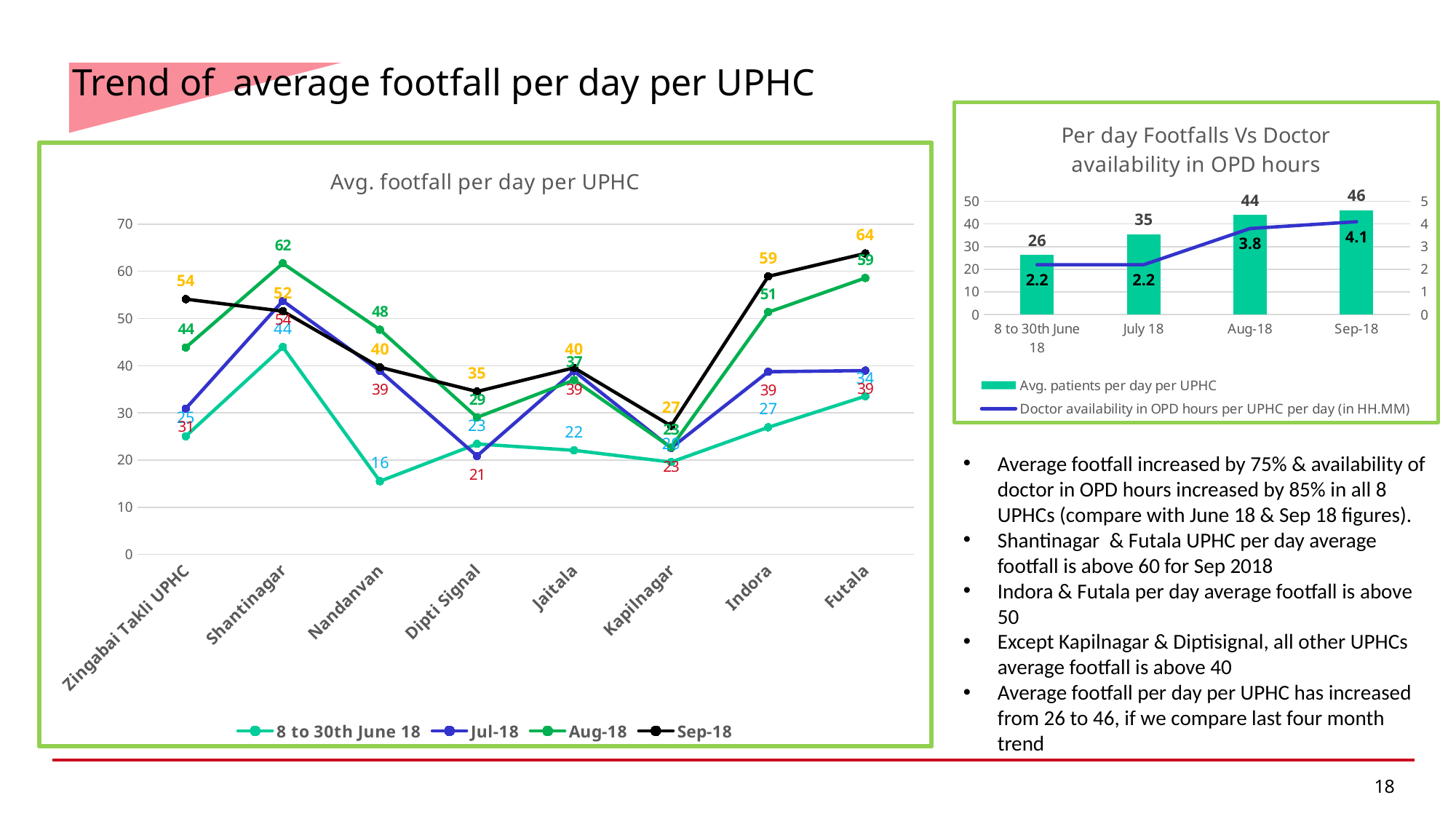
In the 'Per day Footfalls Vs Doctor availability in OPD hours' chart, what is the average patients per day per UPHC for Sep-18? 46 In the 'Per day Footfalls Vs Doctor availability in OPD hours' chart, what is the difference in average patients per day per UPHC between Sep-18 and 8 to 30th June 18? 20 In the 'Per day Footfalls Vs Doctor availability in OPD hours' chart, how many series does the legend list? 2 In the 'Avg. footfall per day per UPHC' chart, what is the Aug-18 value for Shantinagar? 62 In the 'Per day Footfalls Vs Doctor availability in OPD hours' chart, what is the doctor availability in OPD hours for Aug-18? 3.8 In the 'Per day Footfalls Vs Doctor availability in OPD hours' chart, do the average patients per day bars rise or fall from June to Sep-18? rise In the 'Avg. footfall per day per UPHC' chart, what is the Sep-18 value for Futala? 64 What kind of chart is the 'Avg. footfall per day per UPHC' chart? line chart In the 'Avg. footfall per day per UPHC' chart, which UPHC has the lowest value for 8 to 30th June 18? Nandanvan In the 'Avg. footfall per day per UPHC' chart, how many UPHCs are shown on the x axis? 8 In the 'Avg. footfall per day per UPHC' chart, how many series does the legend list? 4 In the 'Per day Footfalls Vs Doctor availability in OPD hours' chart, which month has the highest average patients per day per UPHC? Sep-18